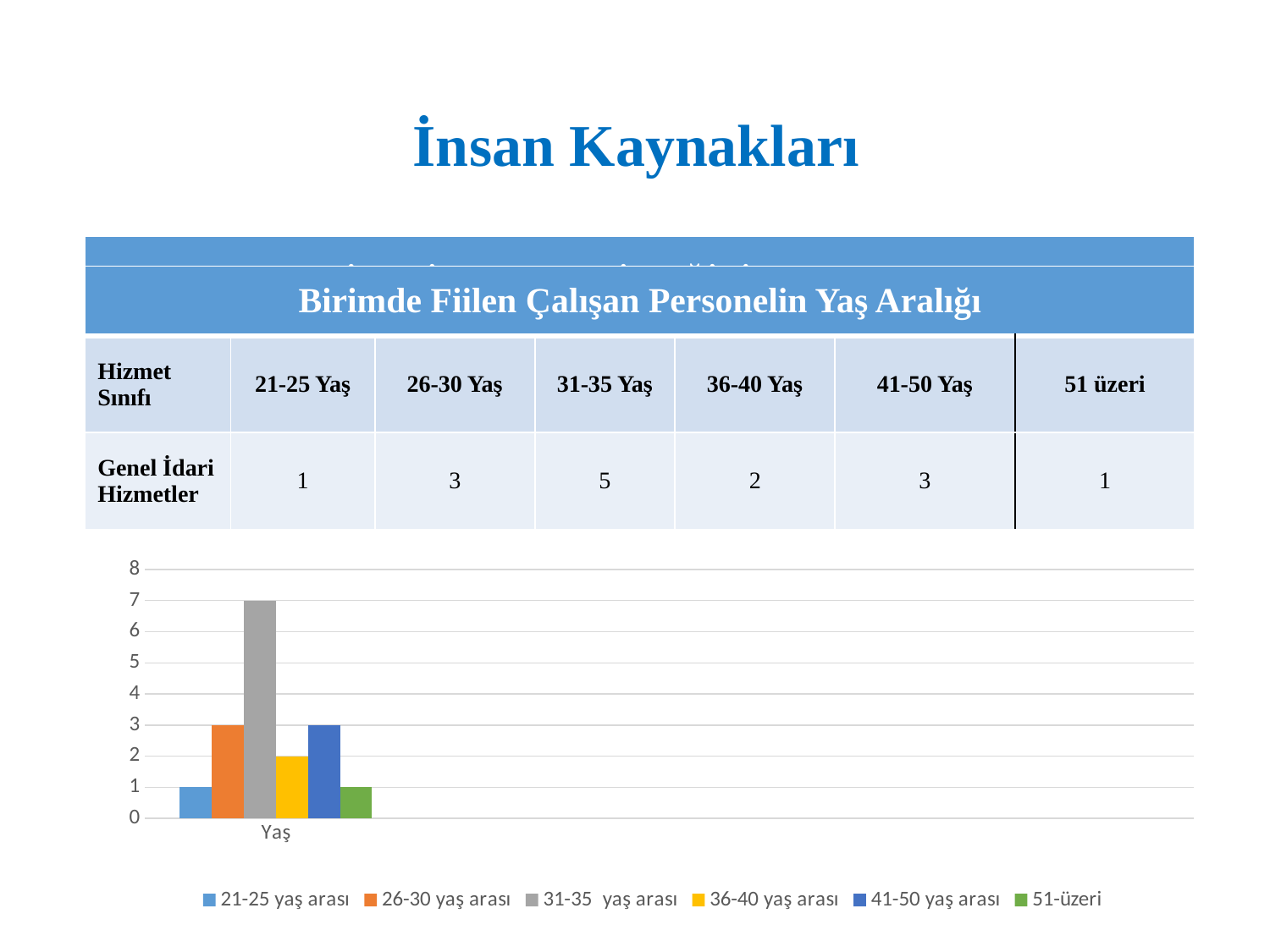
What is the value of the 26-30 yaş arası bar in the chart? 3 What is the difference between the 26-30 yaş arası bar and the 36-40 yaş arası bar in the chart? 1 What is the label on the x axis category of the chart? Yaş What kind of chart is shown on the slide? bar chart Which is larger in the chart, the 26-30 yaş arası bar or the 36-40 yaş arası bar? 26-30 yaş arası What is the value of the 21-25 yaş arası bar in the chart? 1 Is the value for 31-35 yaş arası in the chart greater or less than 6? greater How many categories are shown on the x axis of the chart? 1 What is the value of the 36-40 yaş arası bar in the chart? 2 How many series does the chart legend list? 6 What is the value of the 41-50 yaş arası bar in the chart? 3 Which series has the tallest bar in the chart? 31-35 yaş arası